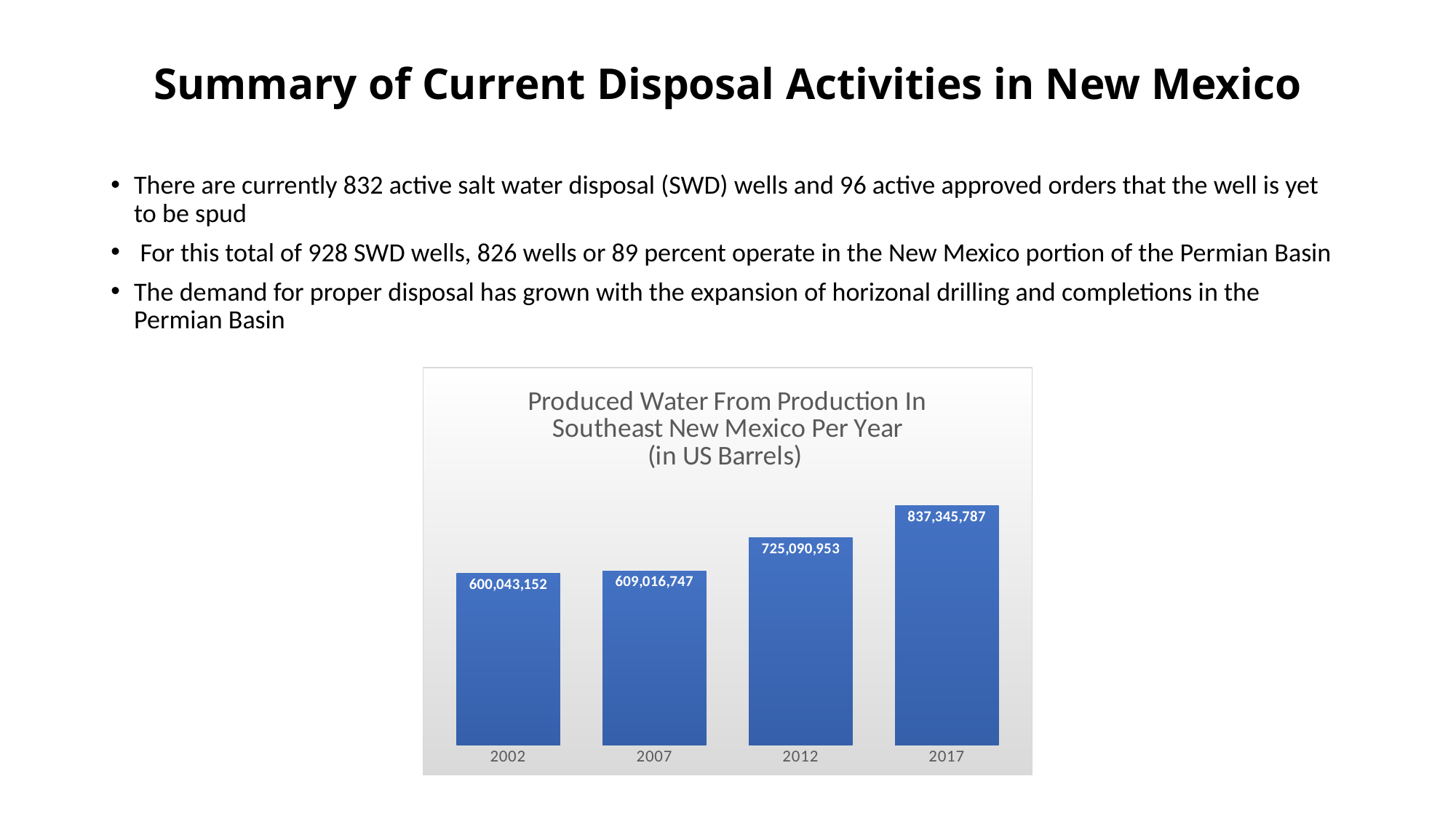
What kind of chart is shown on the slide? Bar chart Which year has the highest produced water value? 2017 Which year has a larger value, 2012 or 2017? 2017 What is the produced water value for 2017? 837,345,787 Do the values rise or fall from 2002 to 2017? Rise What is the produced water value for 2007? 609,016,747 What is the produced water value for 2012? 725,090,953 How many years are shown on the chart? 4 What is the produced water value for 2002? 600,043,152 What is the difference between the 2017 and 2002 values? 237,302,635 Which year has the lowest produced water value? 2002 What is the difference between the 2012 and 2007 values? 116,074,206